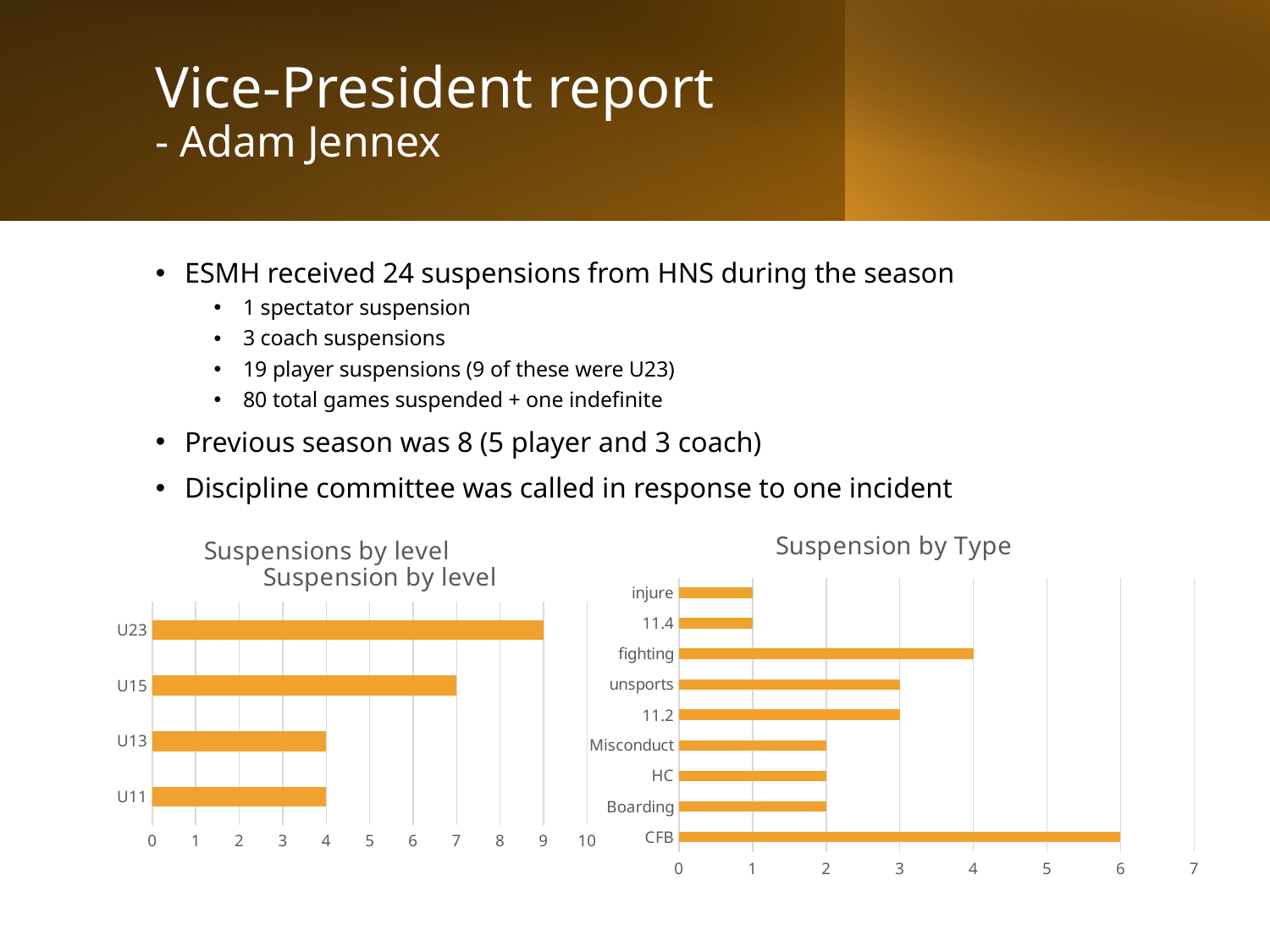
In the 'Suspension by Type' chart, how many suspension types are listed? 9 In the 'Suspension by level' chart, what is the value for U23? 9 In the 'Suspension by Type' chart, what is the value for CFB? 6 In the 'Suspension by Type' chart, what is the difference between the values for CFB and fighting? 2 In the 'Suspension by level' chart, what is the difference between the values for U23 and U15? 2 In the 'Suspension by level' chart, which level has the highest number of suspensions? U23 In the 'Suspension by Type' chart, what is the value for fighting? 4 In the 'Suspension by Type' chart, which is larger, the value for unsports or the value for Misconduct? unsports What kind of chart is the 'Suspension by level' chart? bar chart In the 'Suspension by level' chart, how many levels are shown? 4 In the 'Suspension by level' chart, what is the value for U15? 7 In the 'Suspension by Type' chart, which type has the highest value? CFB